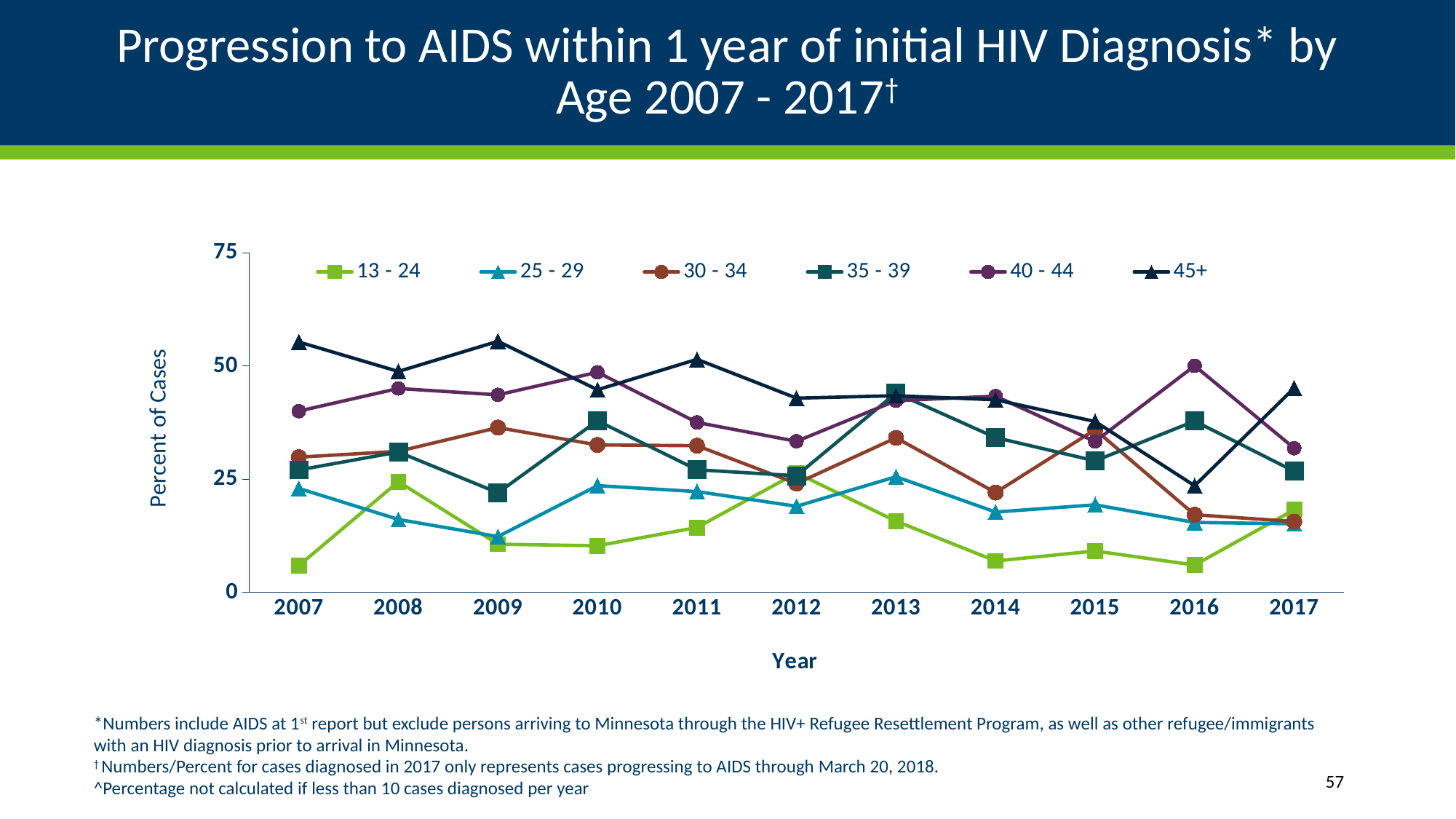
Which age group has the highest value in 2007? 45+ What is the label on the y axis? Percent of Cases Is the value for the 30 - 34 age group in 2009 greater or less than 25? greater Does the value for the 45+ age group rise or fall from 2013 to 2016? fall How many age-group series does the legend list? 6 Which age group has the highest value in 2016? 40 - 44 Is the value for the 13 - 24 age group in 2007 greater or less than 25? less In 2016, which is larger: the value for 13 - 24 or the value for 25 - 29? 25 - 29 Which age group has the lowest value in 2014? 13 - 24 Is the value for the 45+ age group in 2007 greater or less than 50? greater How many years are plotted along the x axis? 11 What kind of chart is shown on the slide? line chart